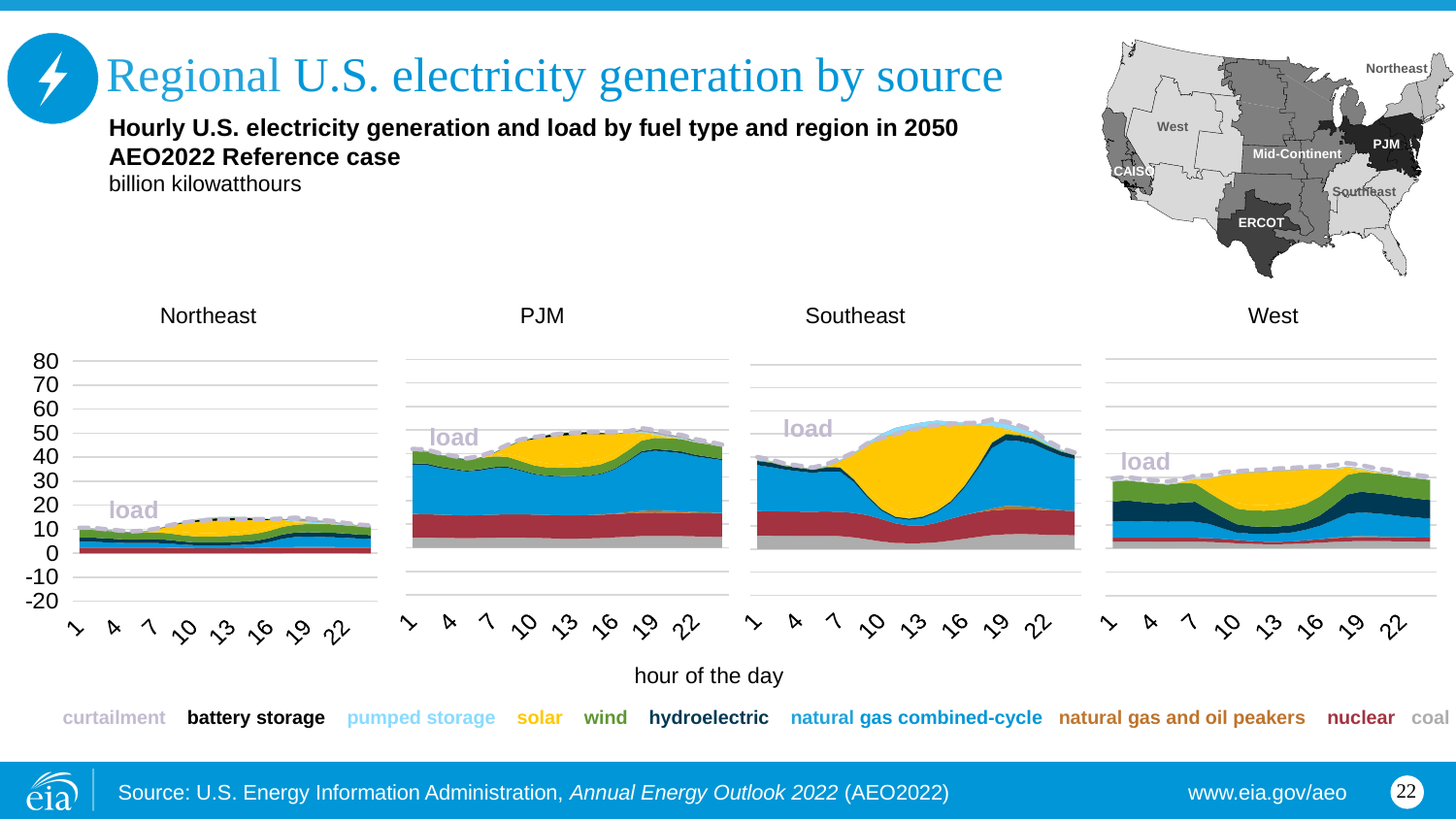
In the West chart, is the peak load value greater or less than 40? less In the PJM chart, is the load at hour 1 greater or less than 30? greater Which region's chart shows the highest peak load: Northeast or Southeast? Southeast Which region's chart shows the lowest peak load among the four regions? Northeast In the Southeast chart, does the solar (yellow) area rise or fall from hour 7 to hour 13? rise How many regional charts are shown on the slide? 4 In the Northeast chart, is the peak load value greater or less than 20? less What kind of chart is used for each of the four regional panels on the slide? stacked area chart What unit is used for the y-axis of the charts? billion kilowatthours What is the label of the shared x-axis beneath the four charts? hour of the day How many fuel-type series does the legend at the bottom of the slide list? 10